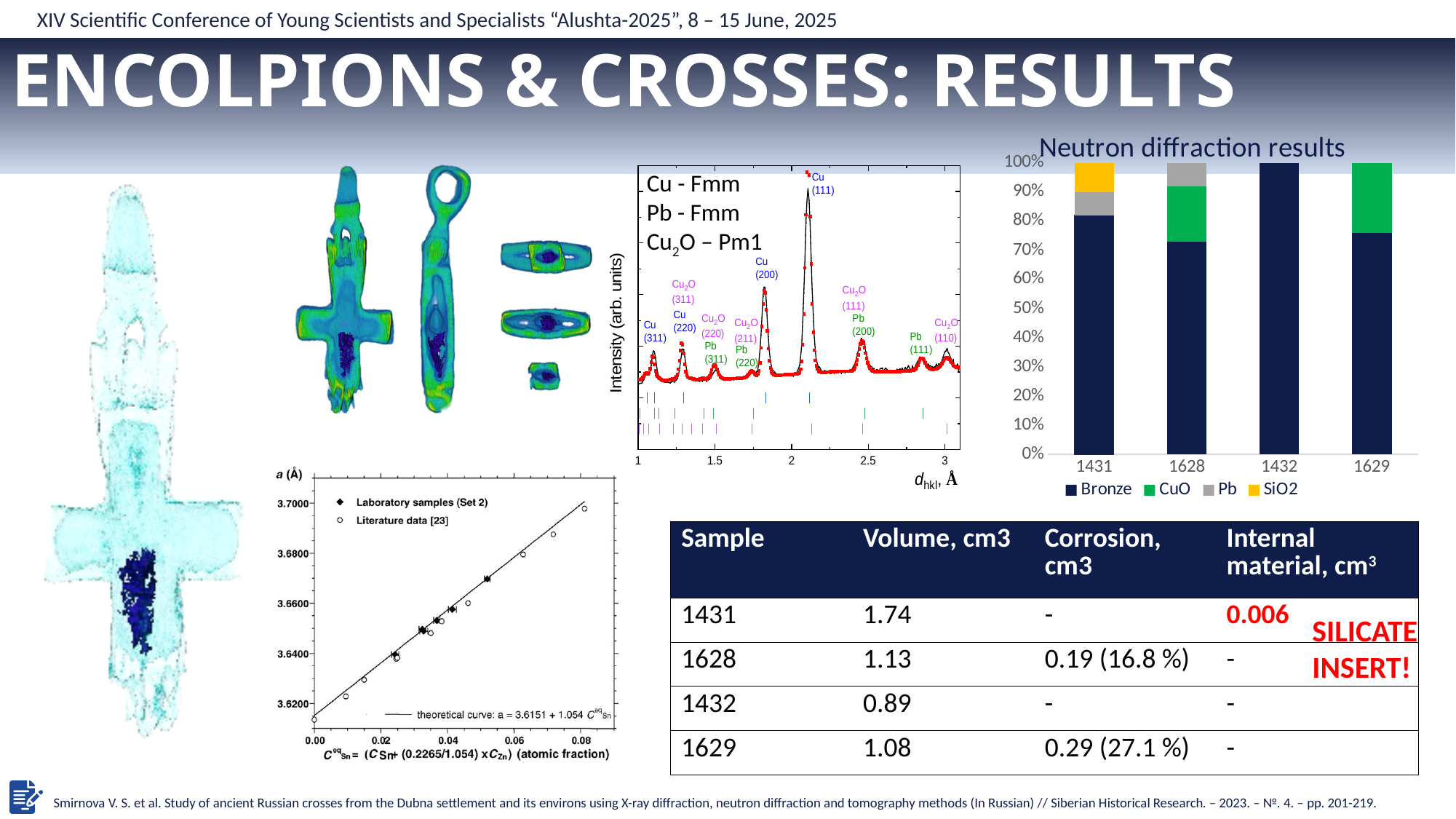
In the 'Neutron diffraction results' chart, what is the Bronze share for sample 1432? 100% How many samples (categories) are shown on the x axis of the 'Neutron diffraction results' chart? 4 In the 'Neutron diffraction results' chart, is the Bronze share for sample 1628 greater or less than 80%? less In the 'Neutron diffraction results' chart, which sample is the only one containing SiO2? 1431 In the 'Neutron diffraction results' chart, which sample has the highest Bronze share? 1432 What is the title of the stacked bar chart on the right of the slide? Neutron diffraction results How many series does the legend of the 'Neutron diffraction results' chart list? 4 In the 'Neutron diffraction results' chart, is the CuO share for sample 1629 greater or less than 30%? less In the scatter plot at the bottom left (lattice parameter a vs. C_Sn), do the values rise or fall as the x value increases? rise In the 'Neutron diffraction results' chart, is the Bronze share for sample 1431 greater or less than 70%? greater What kind of chart is the 'Neutron diffraction results' chart? bar chart In the 'Neutron diffraction results' chart, which sample has a larger CuO share, 1628 or 1629? 1629